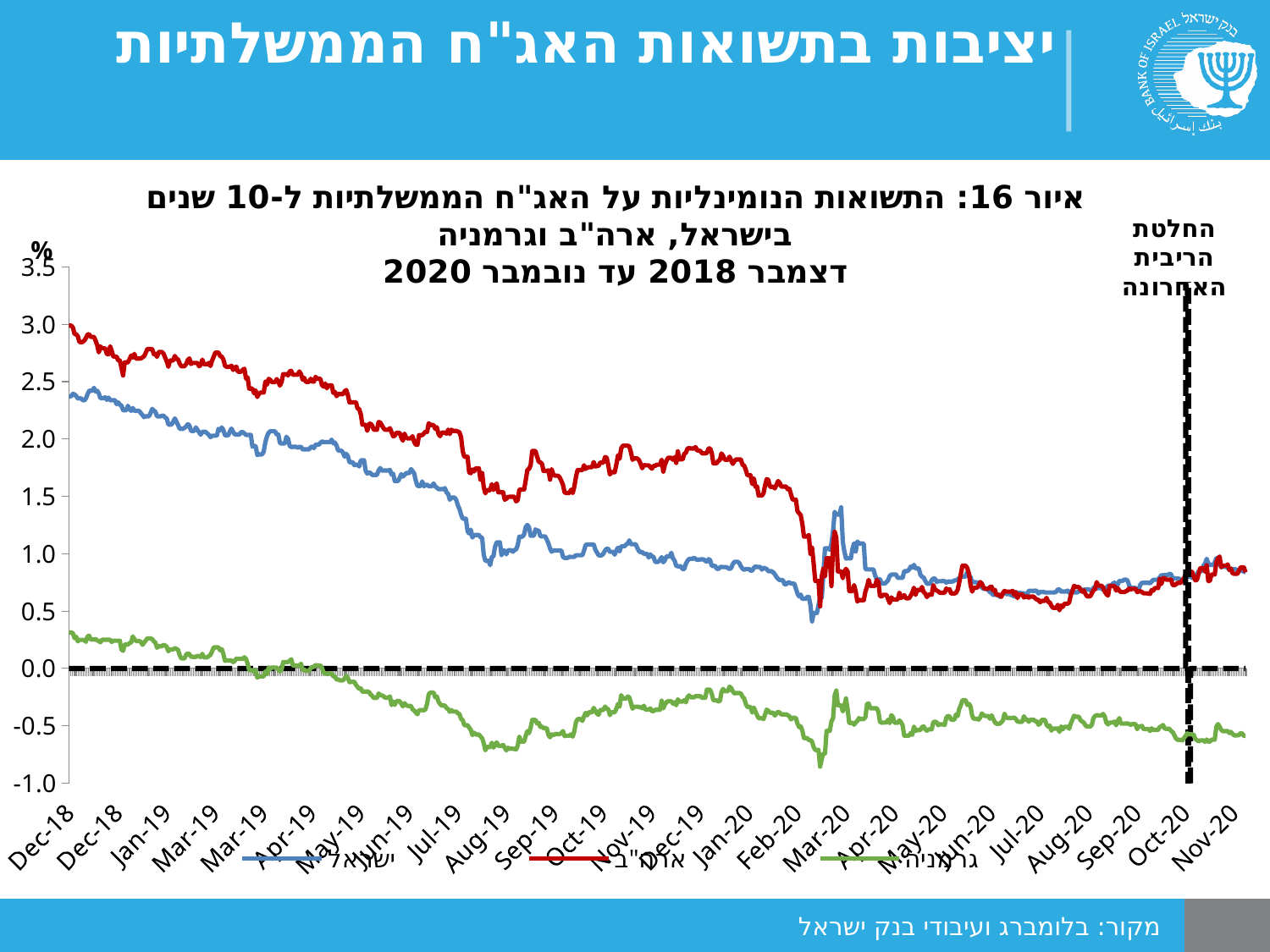
Do the yields for ארה"ב rise or fall overall from Dec-18 to Nov-20? fall Is the value for ישראל in Dec-18 greater or less than 2.0? greater In Dec-18, which is larger, the value for ישראל or the value for ארה"ב? ארה"ב Is the value for גרמניה in Nov-20 greater or less than 0.0? less What does the vertical dashed line on the right of the chart mark? החלטת הריבית האחרונה Which series has the highest value at the start of the period (Dec-18)? ארה"ב How many series does the legend list? 3 Is the value for ארה"ב in Dec-18 greater or less than 2.5? greater What kind of chart is shown on the slide? line chart Which series has the lowest values throughout the period? גרמניה What unit is shown on the y axis? %